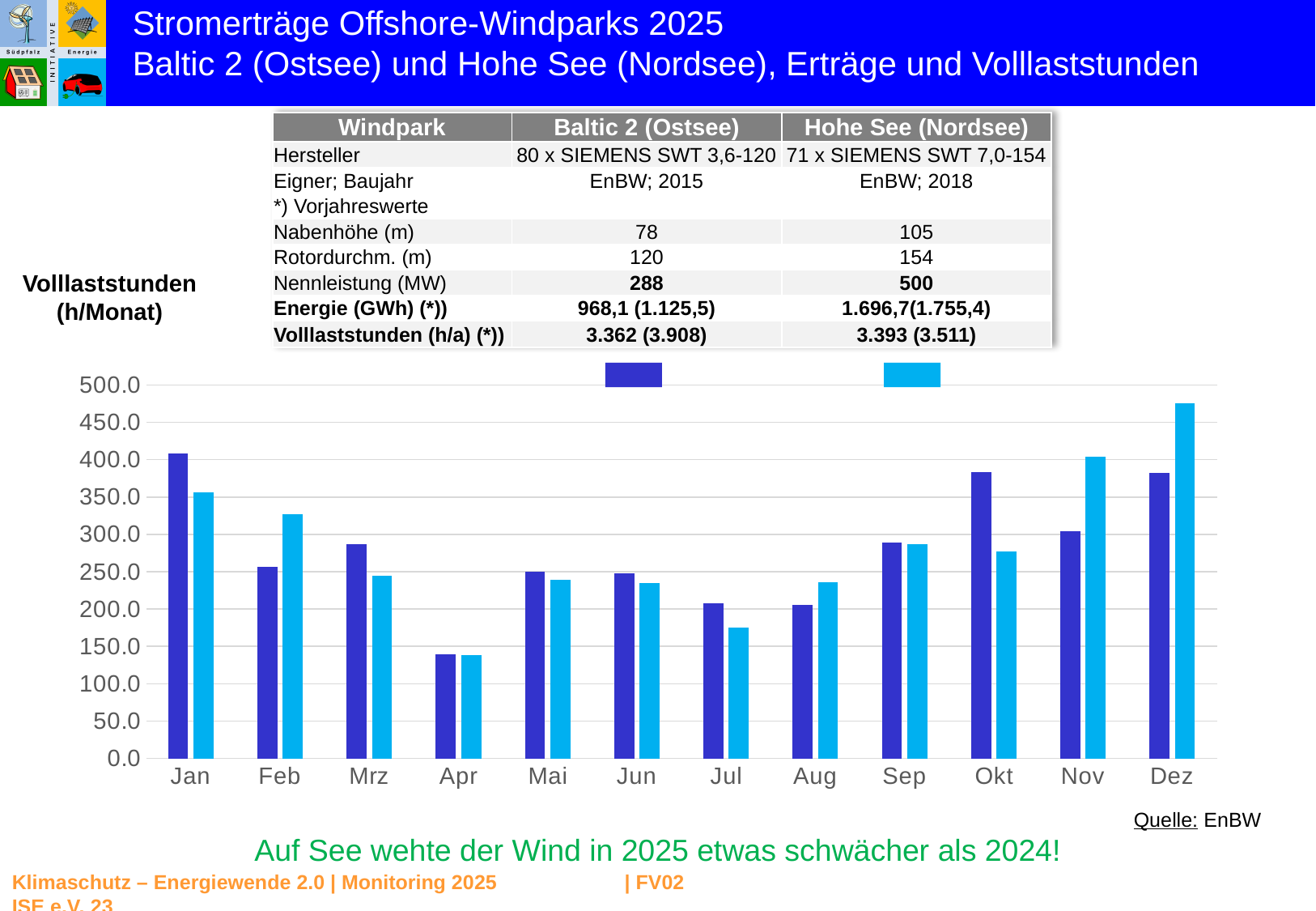
In which month is the dark blue series lowest? Apr What kind of chart is shown on the slide? bar chart In Nov, which series has the larger value, dark blue or light blue? light blue In which month is the light blue series highest? Dez Is the dark blue value for Apr greater or less than 150? less In Jan, which series has the larger value, dark blue or light blue? dark blue Is the light blue value for Dez greater or less than 450? greater In which month is the dark blue series highest? Jan How many series does the chart's legend show? 2 Is the light blue value for Jul greater or less than 200? less From Jan to Apr, does the light blue series rise or fall? fall How many categories (months) are shown on the x axis of the chart? 12